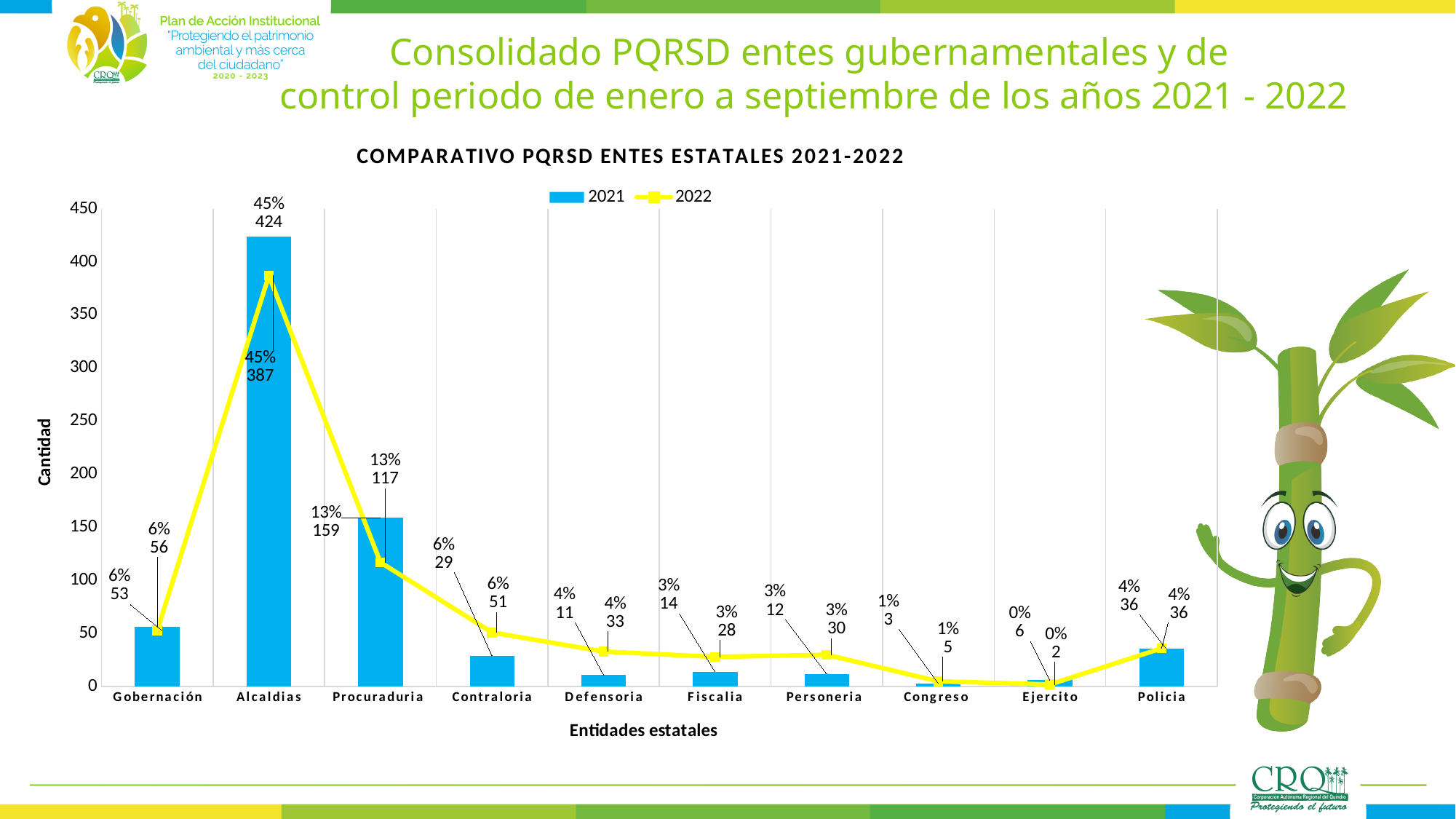
How many entities are shown on the x axis? 10 What kind of chart is used for the 2021 series? Bar chart Which entity had the lowest 2022 value? Ejercito What was the 2022 value for Procuraduria? 117 How many series does the legend list? 2 What was the 2021 value for Alcaldias? 424 Which entity had the highest 2021 value? Alcaldias What is the difference between the 2021 and 2022 values for Alcaldias? 37 Which is larger for Defensoria: the 2021 value or the 2022 value? 2022 What percentage label is shown for Policia in 2022? 4% What was the 2021 value for Contraloria? 29 What is the title of the chart? COMPARATIVO PQRSD ENTES ESTATALES 2021-2022